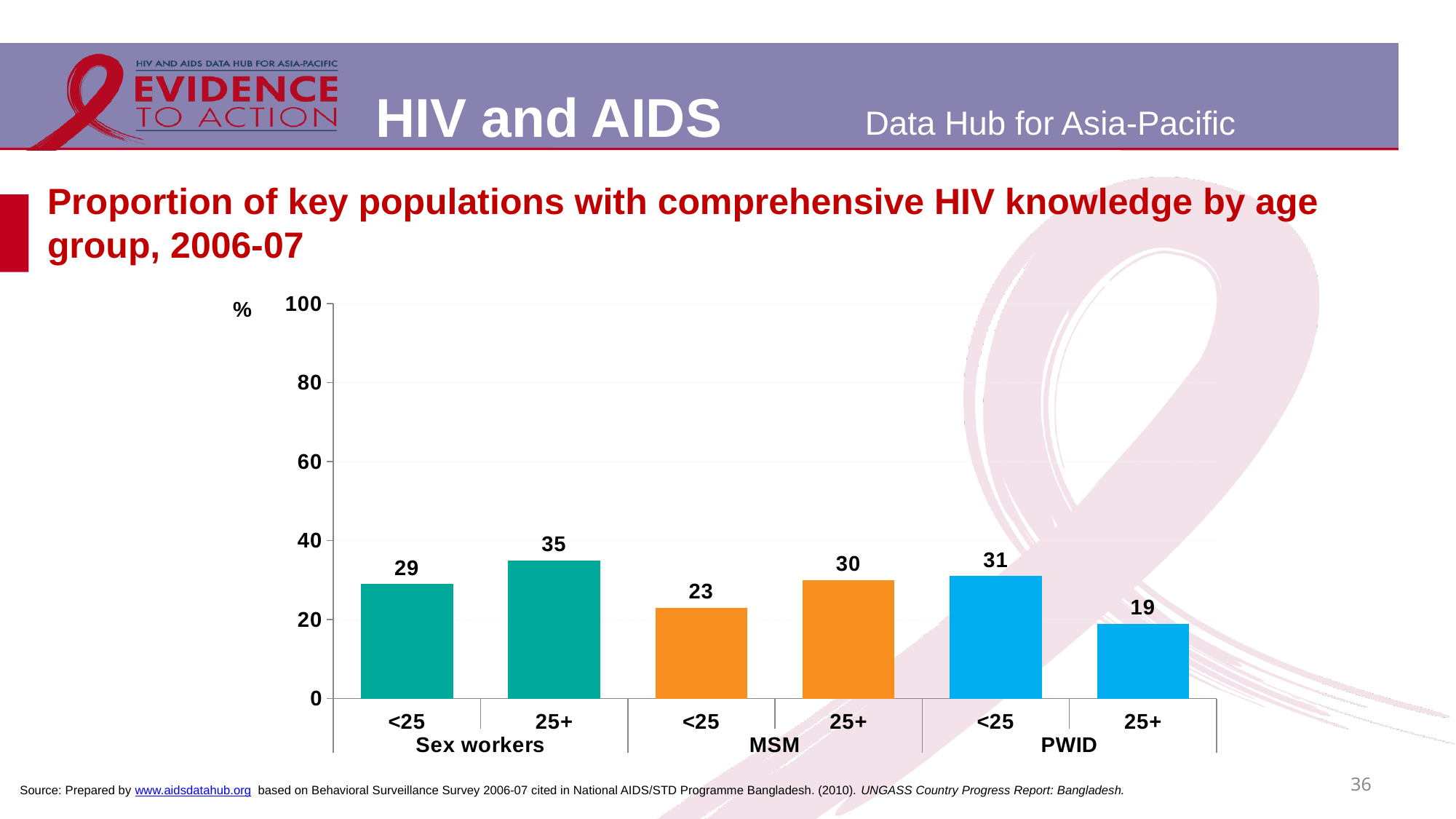
Is the value for sex workers aged 25+ greater or less than 40? less What is the difference between the values for PWID aged <25 and PWID aged 25+? 12 What kind of chart is shown on the slide? Bar chart Which bar has the lowest value? PWID 25+ How many bars are plotted in the chart? 6 Which bar has the highest value? Sex workers 25+ What is the value for PWID aged 25+? 19 What is the value for sex workers aged <25? 29 What is the unit shown on the y axis? % What is the value for MSM aged 25+? 30 How many key population groups are shown on the x axis? 3 Which is larger: the value for MSM aged <25 or the value for MSM aged 25+? MSM 25+